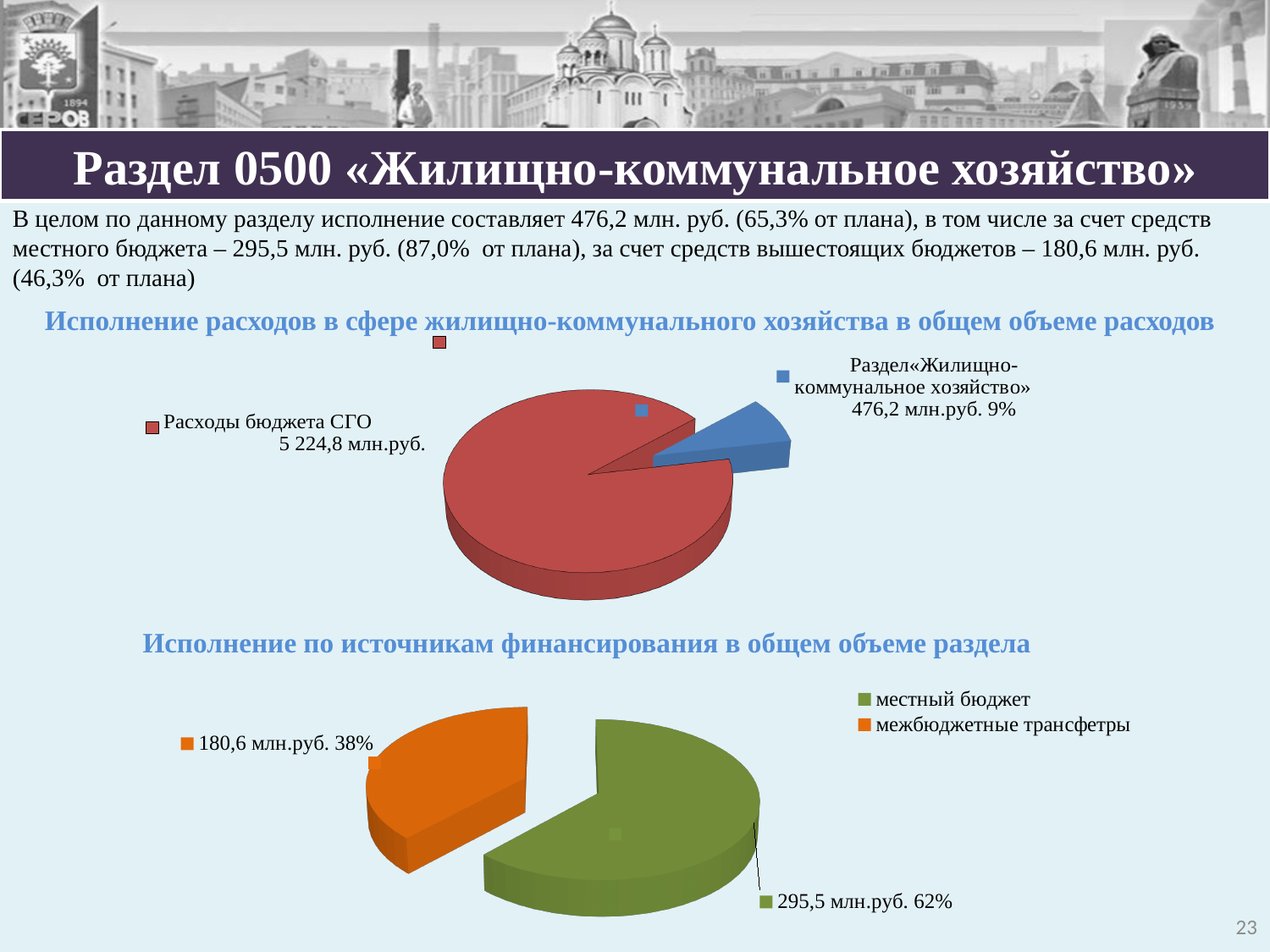
In the bottom pie chart, what share of the pie does «межбюджетные трансферты» represent? 38% In the bottom pie chart, which source has the largest share? местный бюджет In the top pie chart, which slice is larger: «Расходы бюджета СГО» or «Раздел «Жилищно-коммунальное хозяйство»»? Расходы бюджета СГО In the top pie chart, what value is shown for «Расходы бюджета СГО»? 5 224,8 млн.руб. In the top pie chart, what value is shown for «Раздел «Жилищно-коммунальное хозяйство»»? 476,2 млн.руб. How many entries does the legend of the bottom pie chart list? 2 In the bottom pie chart, what value is shown for «местный бюджет»? 295,5 млн.руб. In the bottom pie chart, what colour is the slice for «межбюджетные трансферты»? orange What type of chart is the top chart titled «Исполнение расходов в сфере жилищно-коммунального хозяйства в общем объеме расходов»? pie chart In the top pie chart, what share of the pie does «Раздел «Жилищно-коммунальное хозяйство»» represent? 9% How many slices does the top pie chart have? 2 What type of chart is the bottom chart titled «Исполнение по источникам финансирования в общем объеме раздела»? pie chart